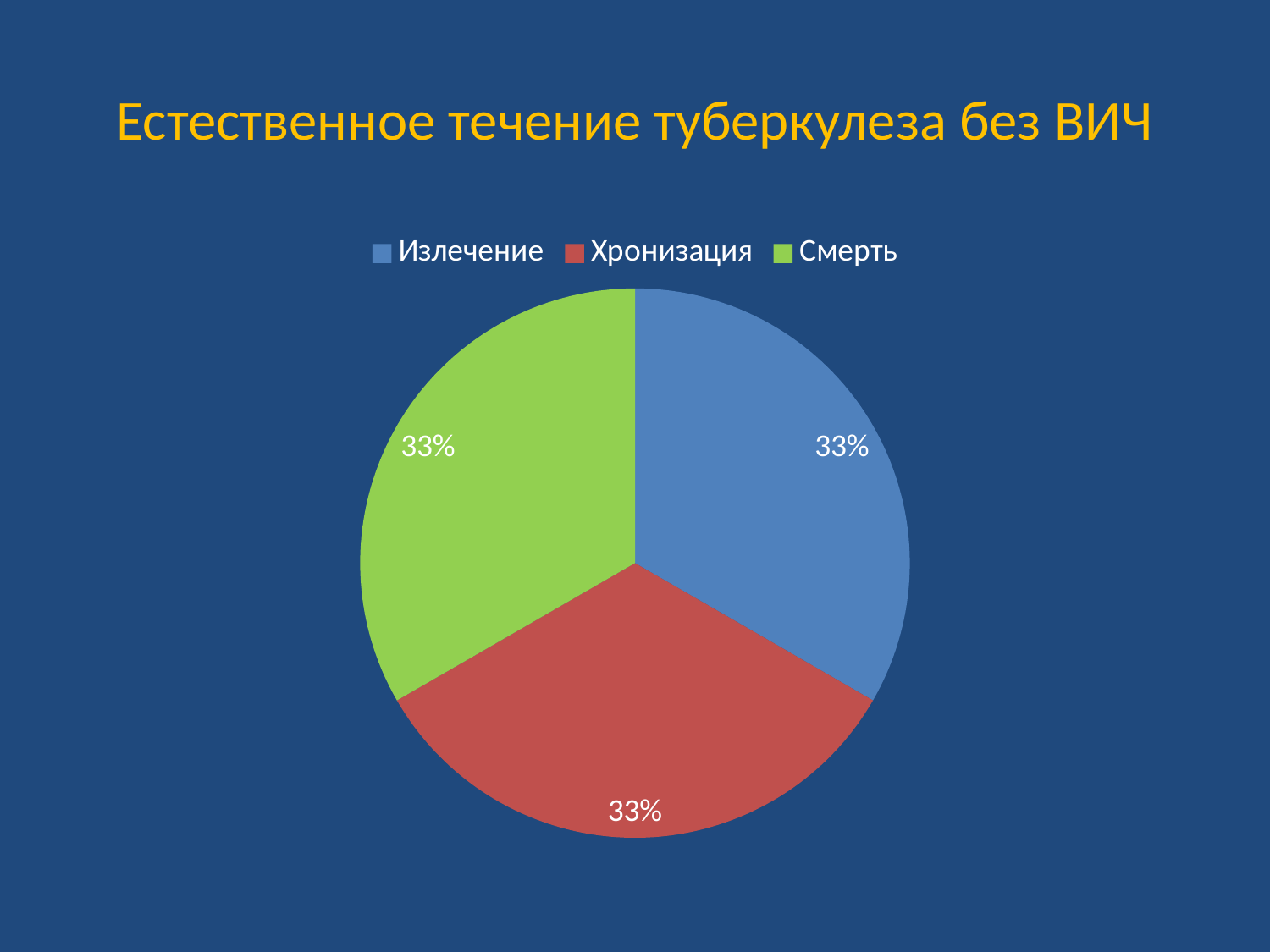
What percentage is shown for Хронизация? 33% What percentage is shown for Смерть? 33% What is the difference between the values for Излечение and Хронизация? 0% What percentage is shown for Излечение? 33% How many slices does the pie chart have? 3 Which colour represents Хронизация in the pie chart? red Is the value for Излечение greater or less than 50%? less What share of the pie does the Смерть slice represent? 33% What is the title of the chart on the slide? Естественное течение туберкулеза без ВИЧ What kind of chart is shown on the slide? pie chart How many entries does the legend list? 3